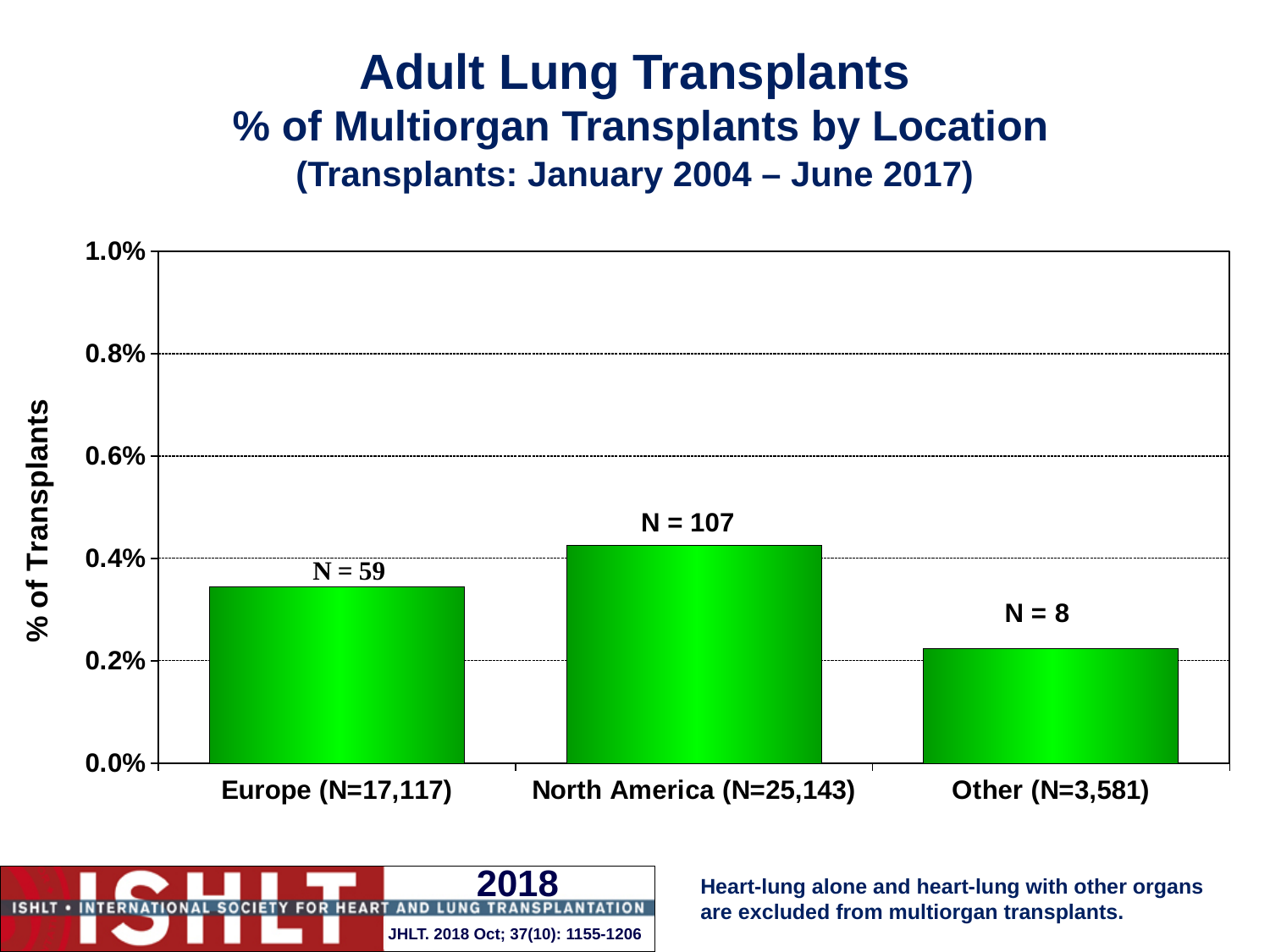
Is the % of transplants for Europe greater or less than 0.4%? less How many more multiorgan transplants (N) are labelled for North America than for Europe? 48 What is the N value labelled above the Other bar? N = 8 Is the % of transplants for Other greater or less than 0.4%? less Is the % of transplants for North America greater or less than 0.6%? less How many location categories are plotted on the chart? 3 Which location has the highest % of multiorgan transplants? North America (N=25,143) Which has a higher % of multiorgan transplants, Europe or Other? Europe What is the N value labelled above the North America bar? N = 107 What kind of chart is shown on the slide? bar chart What is the N value labelled above the Europe bar? N = 59 Which location has the lowest % of multiorgan transplants? Other (N=3,581)